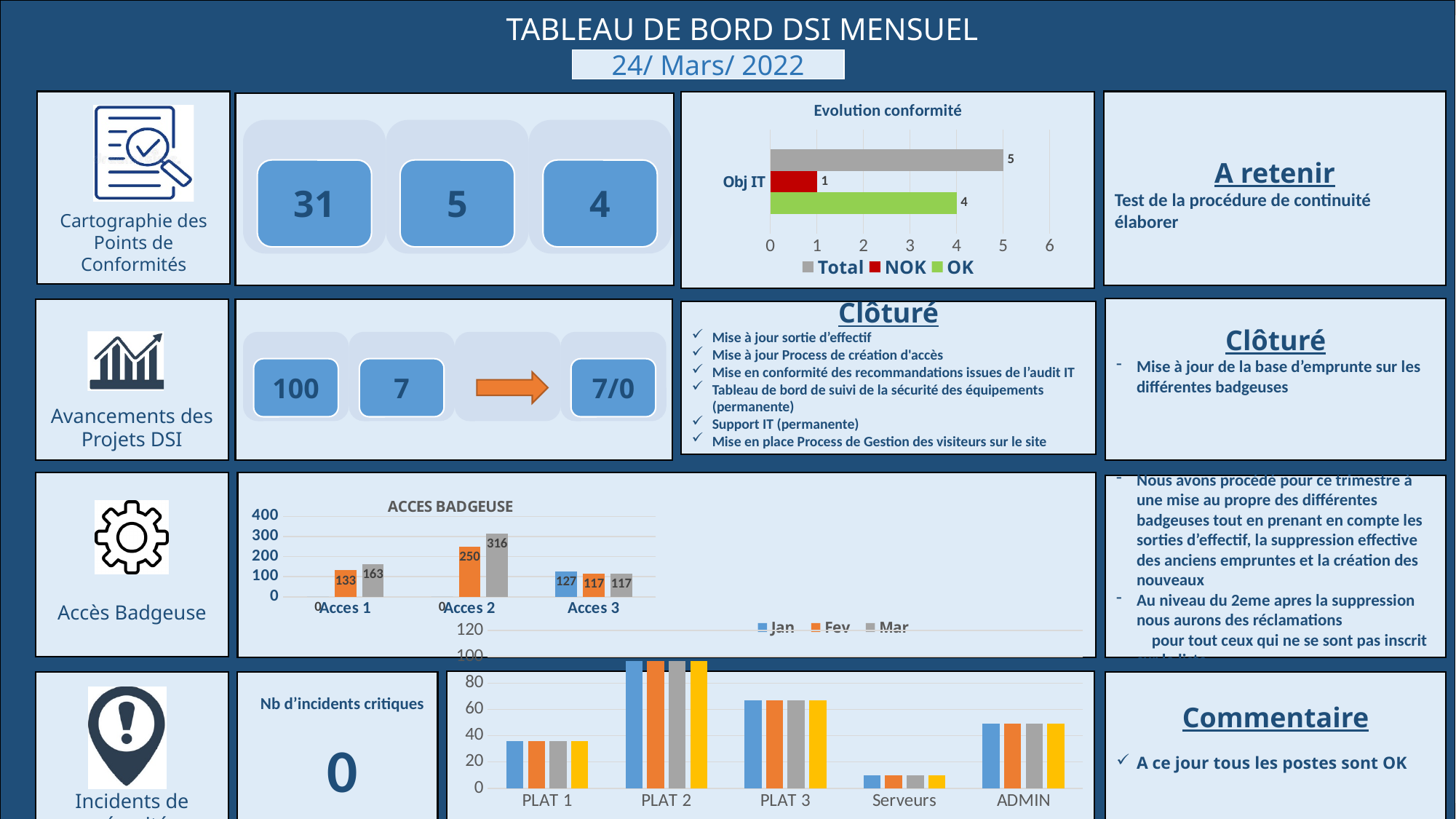
In the 'Evolution conformité' chart, what is the value of the Total series for Obj IT? 5 In the 'ACCES BADGEUSE' chart, which is larger for Acces 3: the Jan value or the Fev value? Jan In the 'ACCES BADGEUSE' chart, what is the Fev value for Acces 1? 133 In the 'Evolution conformité' chart, what is the value of the NOK series? 1 How many series does the legend of the 'Evolution conformité' chart list? 3 In the 'Evolution conformité' chart, what is the difference between the OK value and the NOK value? 3 In the 'ACCES BADGEUSE' chart, which category has the highest Mar value? Acces 2 What kind of chart is the 'Evolution conformité' chart? Bar chart In the bottom chart with categories PLAT 1 to ADMIN, is the value for Serveurs greater or less than 20? less In the 'ACCES BADGEUSE' chart, what is the Mar value for Acces 2? 316 In the 'ACCES BADGEUSE' chart, what is the difference between the Fev and Mar values for Acces 2? 66 How many categories are shown on the x axis of the bottom chart (PLAT 1 to ADMIN)? 5